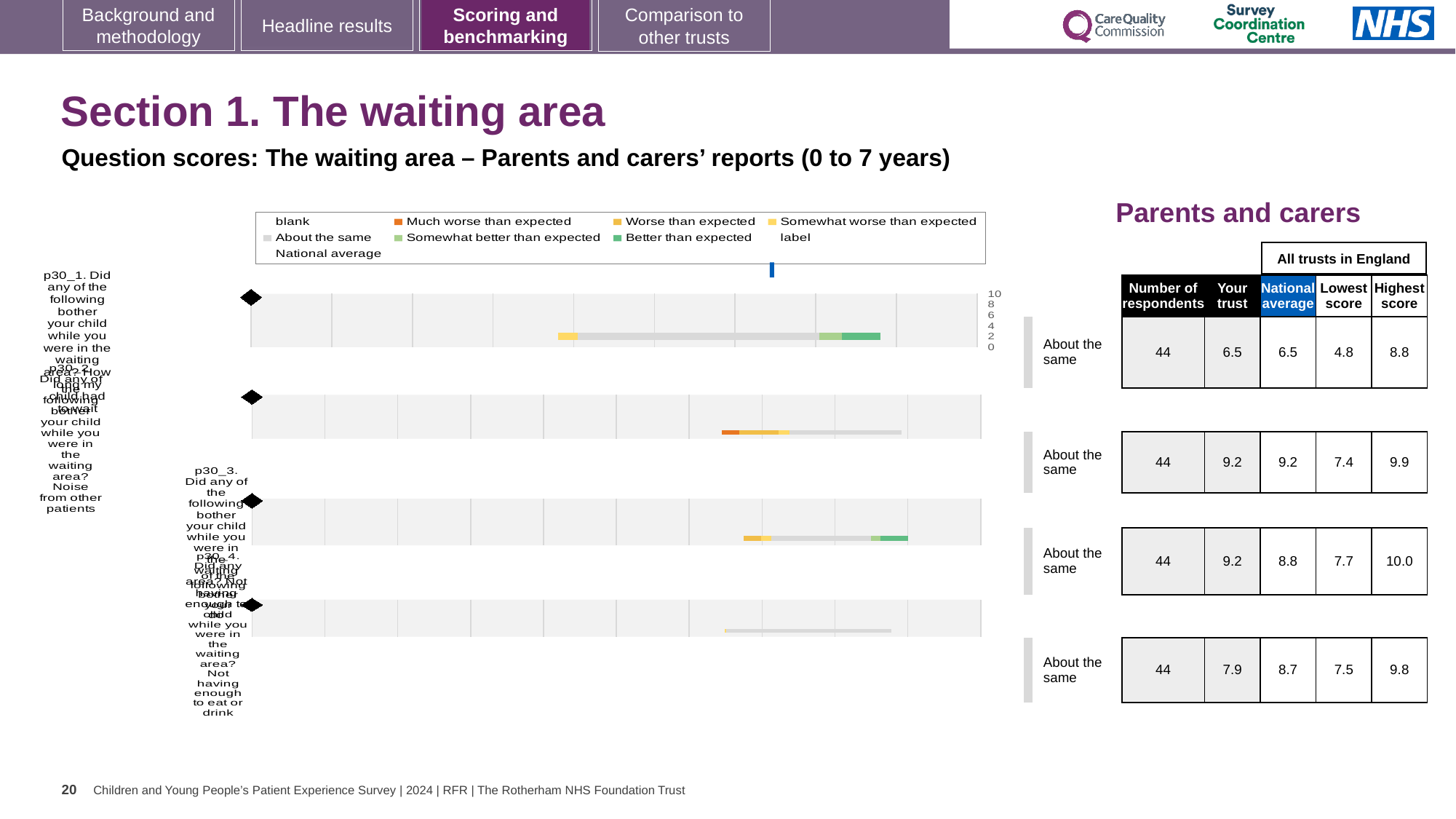
How many respondents are listed for each question row? 44 Is the 'Your trust' score for the second question row (p30_2) larger or smaller than the 'Your trust' score for the fourth row (p30_4)? larger What is the difference between the highest score and the lowest score for the first question row (p30_1)? 4.0 What is the 'Your trust' score for the fourth question row (p30_4)? 7.9 What is the national average for the third question row (p30_3)? 8.8 What is the highest score across all trusts in England for the third question row (p30_3)? 10.0 What is the 'Your trust' score for the first question row (p30_1)? 6.5 What kind of chart is shown on the slide? bar chart Which legend entry is shown in orange? Much worse than expected How many entries does the chart legend list? 9 Which question row has the lowest 'Your trust' score? p30_1 How many question rows (bars) does the chart show? 4